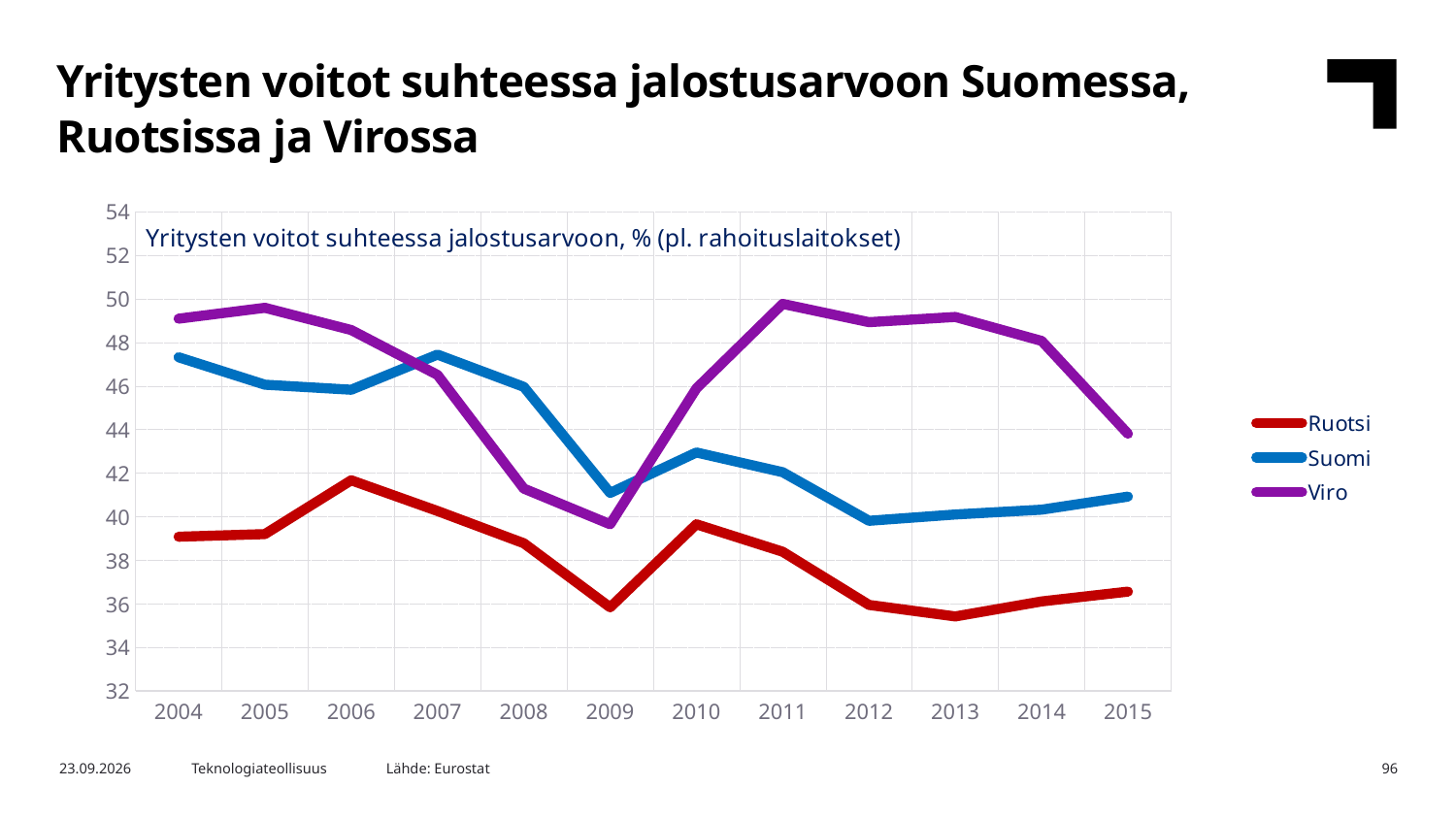
Is the value for Suomi in 2004 greater or less than 46? greater How many series does the legend list? 3 In 2004, which is higher, Viro or Suomi? Viro Does the Viro line rise or fall from 2011 to 2015? Fall What kind of chart is shown on the slide? Line chart How many years are shown on the x axis? 12 In which year does the Viro line reach its lowest value? 2009 Is the value for Ruotsi in 2009 greater or less than 38? less Which colour is used for the Viro line? Purple Is the value for Viro in 2015 greater or less than 46? less In 2008, which is higher, Suomi or Viro? Suomi In which year does the Ruotsi line reach its highest value? 2006